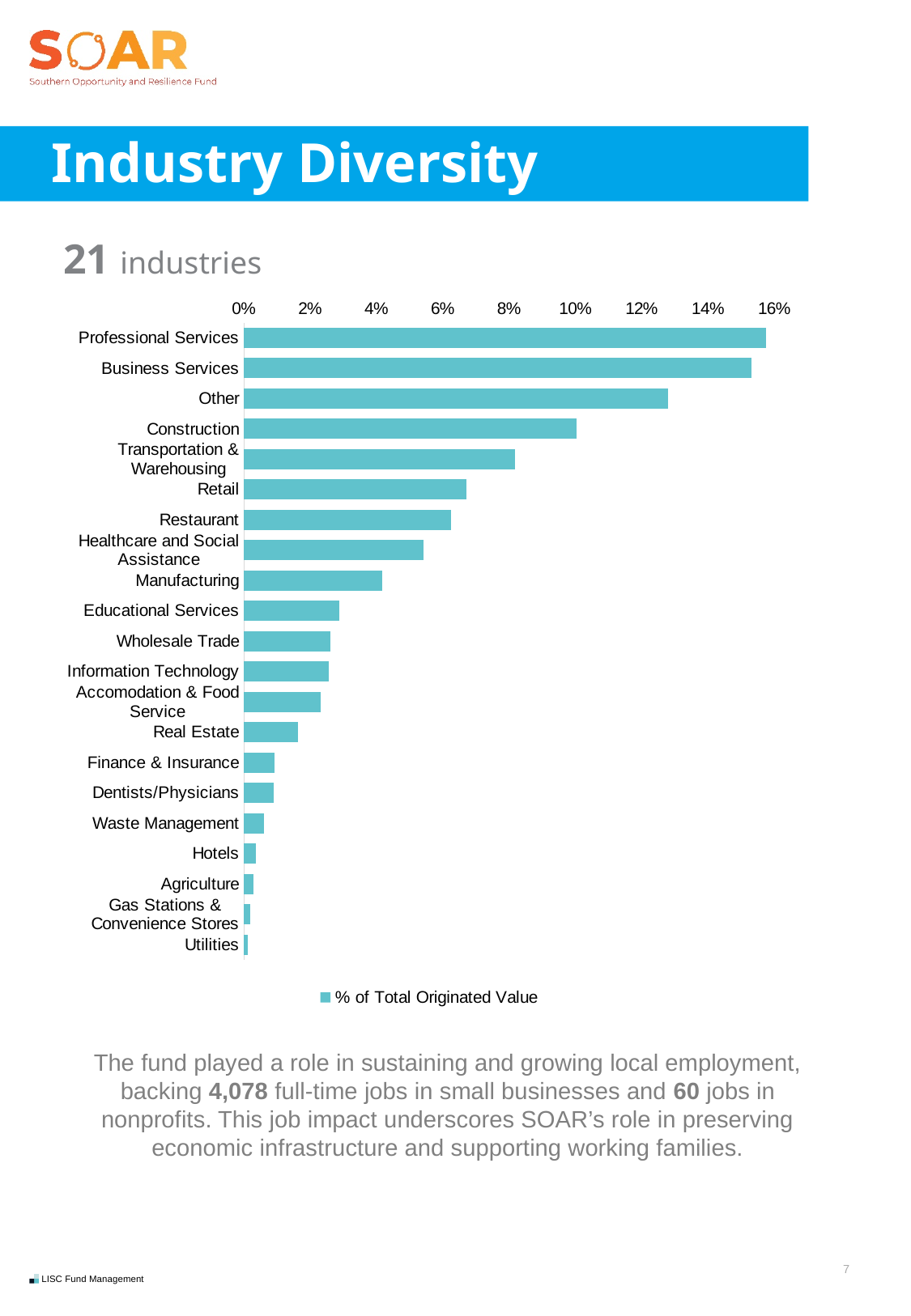
Is the value for Real Estate greater or less than 2%? less Which has a larger % of Total Originated Value, Other or Construction? Other How many series does the chart legend list? 1 Do the bar lengths increase or decrease from the top of the chart to the bottom? decrease Which industry has the lowest % of Total Originated Value? Utilities How many industries (categories) are plotted in the chart? 21 Is the value for Other greater or less than 12%? greater What is the name of the series shown in the chart legend? % of Total Originated Value What kind of chart is shown on the slide? Bar chart Which industry has the highest % of Total Originated Value? Professional Services Is the value for Healthcare and Social Assistance greater or less than 6%? less